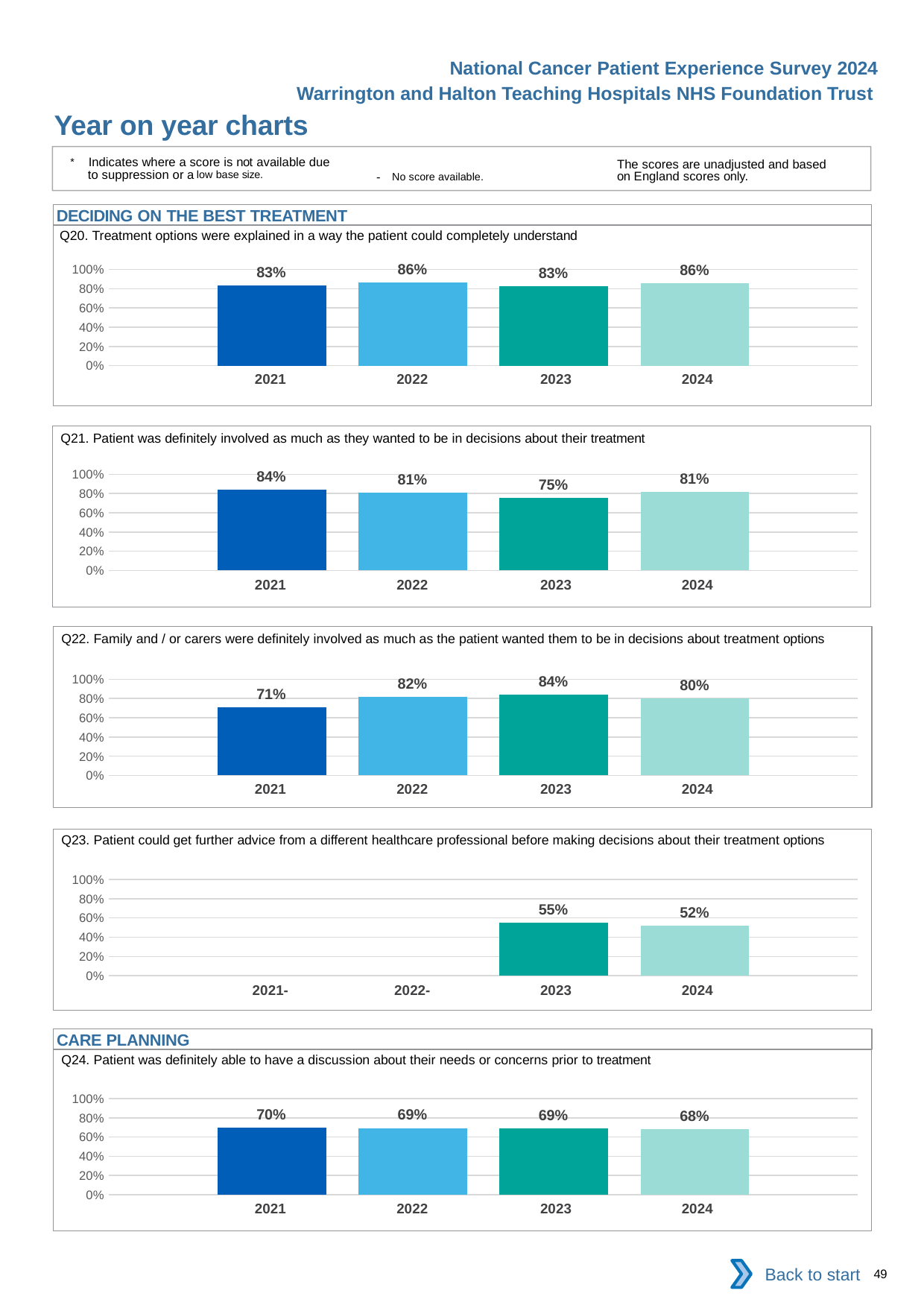
In the Q24 chart, which is larger, the value for 2021 or the value for 2024? 2021 In the Q21 chart, which year has the lowest value? 2023 In the Q20 chart, what is the value for 2022? 86% In the Q22 chart, what is the difference between the 2022 and 2024 values? 2% In the Q22 chart, what is the value for 2021? 71% In the Q22 chart, which year has the highest value? 2023 What kind of chart is the Q20 chart? bar chart In the Q23 chart, what is the value for 2024? 52% In the Q23 chart, how many years have a bar plotted? 2 In the Q21 chart, what is the difference between the 2021 and 2023 values? 9% In the Q23 chart, is the value for 2023 greater or less than 60%? less In the Q24 chart, what is the value for 2023? 69%